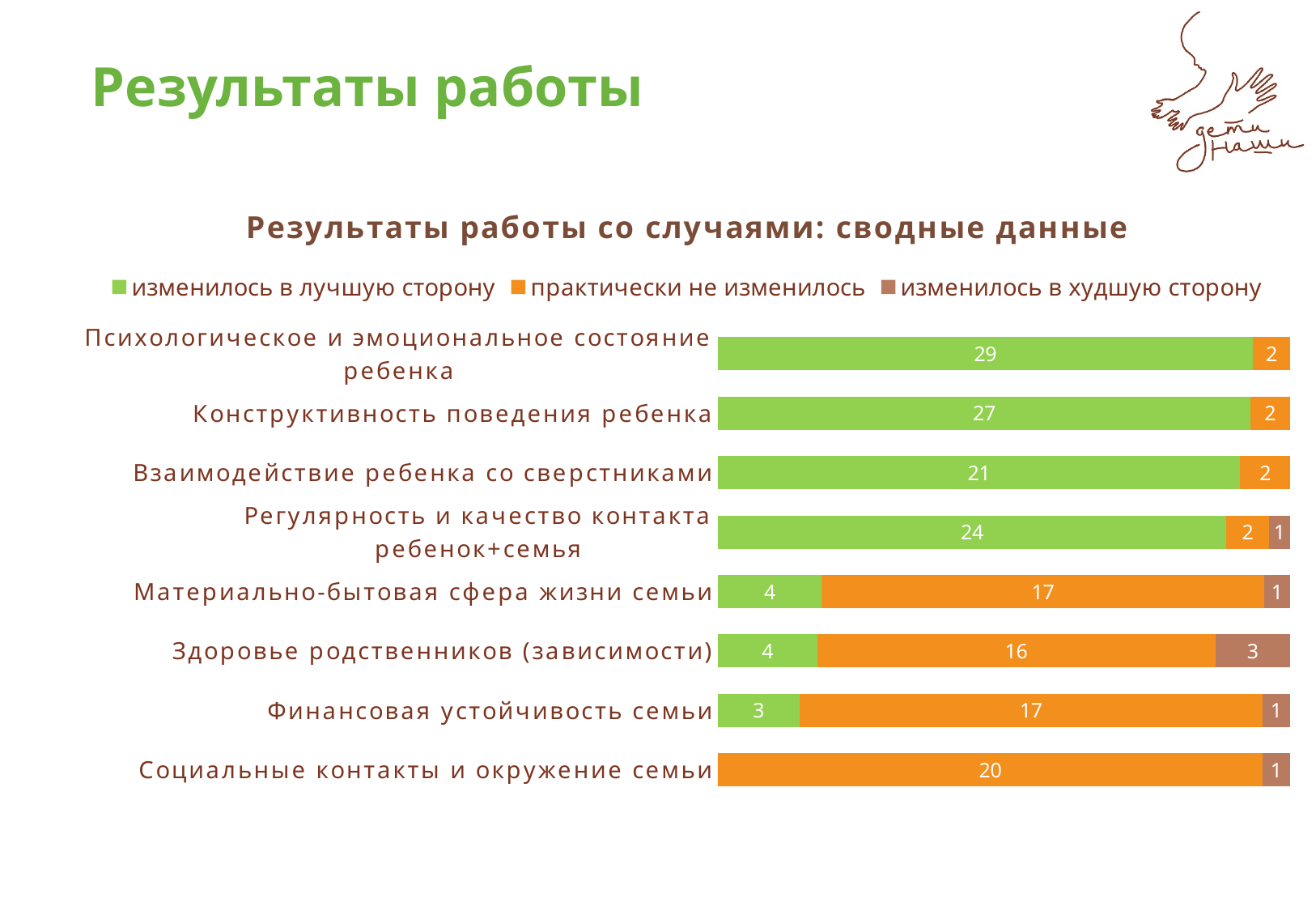
What is the value of "изменилось в лучшую сторону" for "Психологическое и эмоциональное состояние ребенка"? 29 Which category has the highest value for "изменилось в лучшую сторону"? Психологическое и эмоциональное состояние ребенка How many series does the legend list? 3 What is the value of "практически не изменилось" for "Здоровье родственников (зависимости)"? 16 What is the title of the chart? Результаты работы со случаями: сводные данные How many categories are plotted in the chart? 8 Which is larger: the "практически не изменилось" value for "Материально-бытовая сфера жизни семьи" or for "Здоровье родственников (зависимости)"? Материально-бытовая сфера жизни семьи What is the total of the stacked bar for "Регулярность и качество контакта ребенок+семья"? 27 What is the difference between the "изменилось в лучшую сторону" values for "Психологическое и эмоциональное состояние ребенка" and "Конструктивность поведения ребенка"? 2 What kind of chart is shown on the slide? stacked bar chart Which category has the lowest value for "изменилось в лучшую сторону" among those with a green segment? Финансовая устойчивость семьи What is the value of "изменилось в худшую сторону" for "Здоровье родственников (зависимости)"? 3